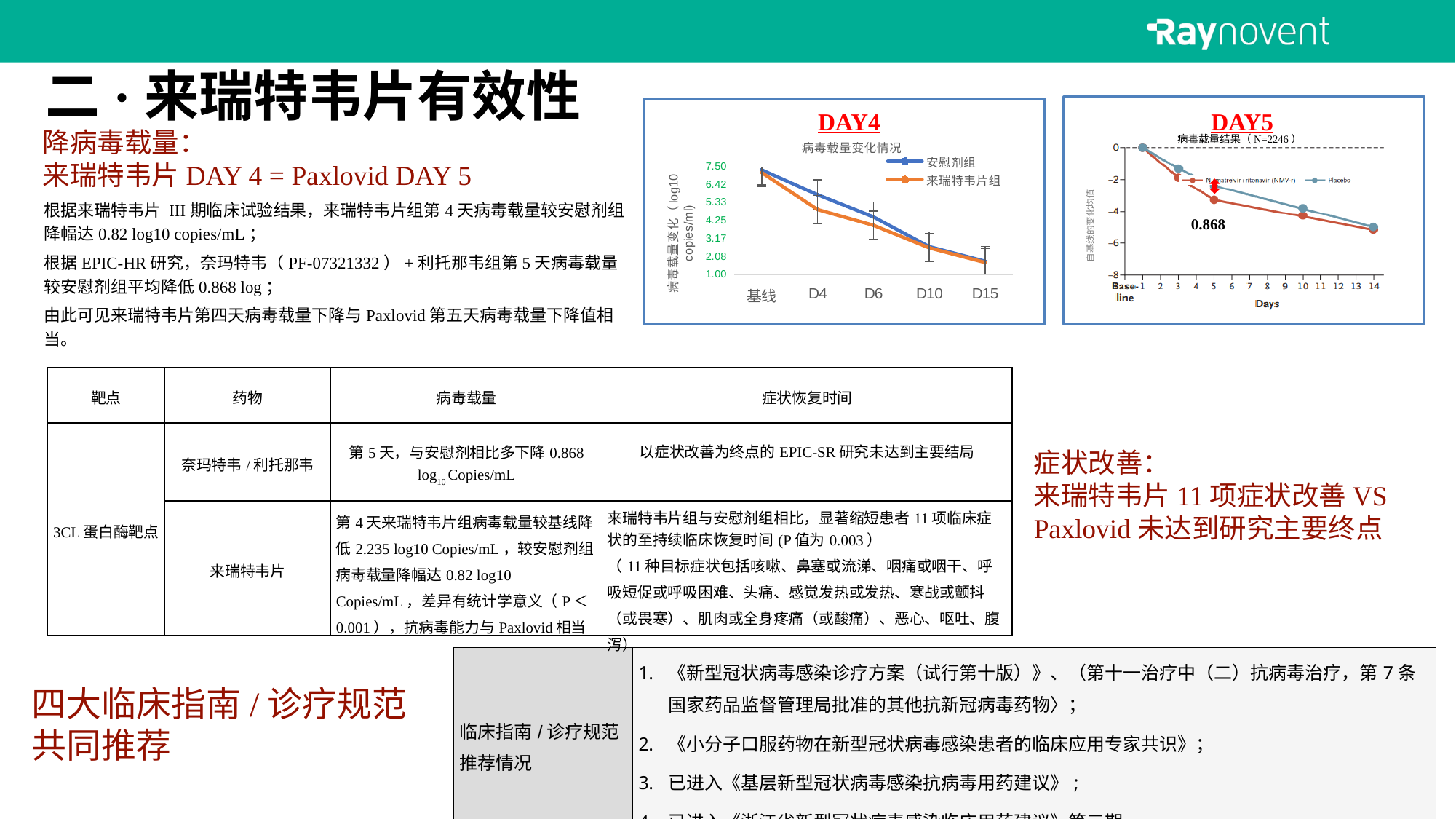
In the DAY4 chart (病毒载量变化情况), is the value for 来瑞特韦片组 at D15 greater or less than 3.17? less In the DAY4 chart (病毒载量变化情况), do the values rise or fall from 基线 to D15? fall In the DAY5 chart (病毒载量结果), is the value for Placebo at day 14 greater or less than -4? less What are the two legend entries of the DAY4 chart (病毒载量变化情况)? 安慰剂组, 来瑞特韦片组 How many series does the legend of the DAY4 chart (病毒载量变化情况) list? 2 In the DAY5 chart (病毒载量结果), which series has the lower value at day 5, Nirmatrelvir+ritonavir (NMV-r) or Placebo? Nirmatrelvir+ritonavir (NMV-r) What kind of chart is the DAY4 chart titled 病毒载量变化情况? line chart How many categories are shown on the x axis of the DAY4 chart (病毒载量变化情况)? 5 What is the title of the DAY5 chart on the right? 病毒载量结果（N=2246） In the DAY4 chart (病毒载量变化情况), is the value for 安慰剂组 at 基线 greater or less than 6.42? greater How many series does the legend of the DAY5 chart (病毒载量结果) list? 2 In the DAY4 chart (病毒载量变化情况), which series has the higher value at D4, 安慰剂组 or 来瑞特韦片组? 安慰剂组